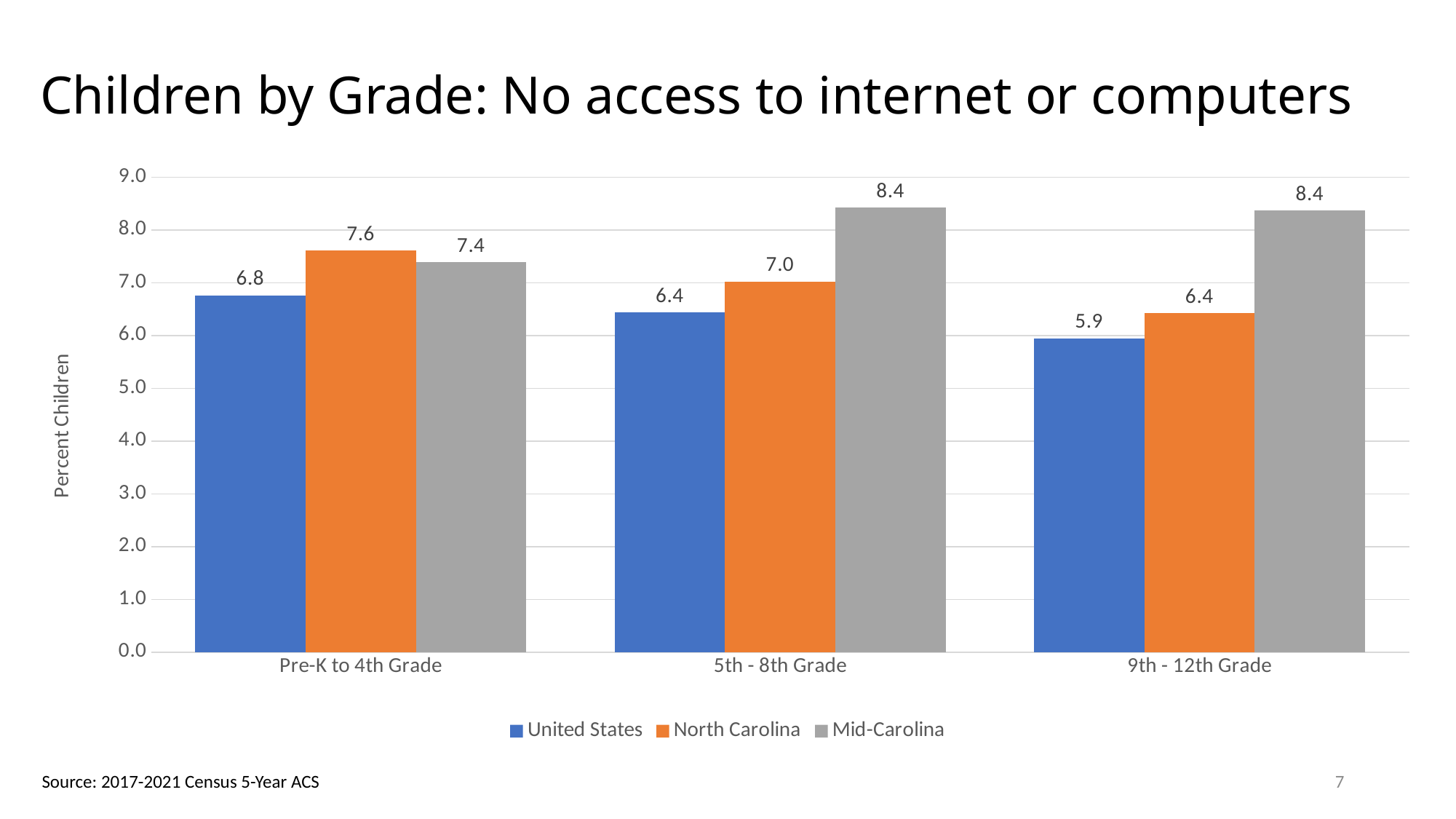
What is the value for North Carolina in the 5th - 8th Grade category? 7.0 What kind of chart is shown on the slide? Bar chart How many grade categories are shown on the x axis? 3 In the Pre-K to 4th Grade category, which is larger: North Carolina or Mid-Carolina? North Carolina What is the value for Mid-Carolina in the 9th - 12th Grade category? 8.4 Do the United States values rise or fall from Pre-K to 4th Grade to 9th - 12th Grade? Fall How many series does the legend list? 3 What is the value for United States in the Pre-K to 4th Grade category? 6.8 Is the value for Mid-Carolina in the 5th - 8th Grade category greater or less than 8.0? greater Which grade category has the highest value for North Carolina? Pre-K to 4th Grade What is the difference between the Mid-Carolina and United States values in the 9th - 12th Grade category? 2.5 Which grade category has the lowest value for United States? 9th - 12th Grade